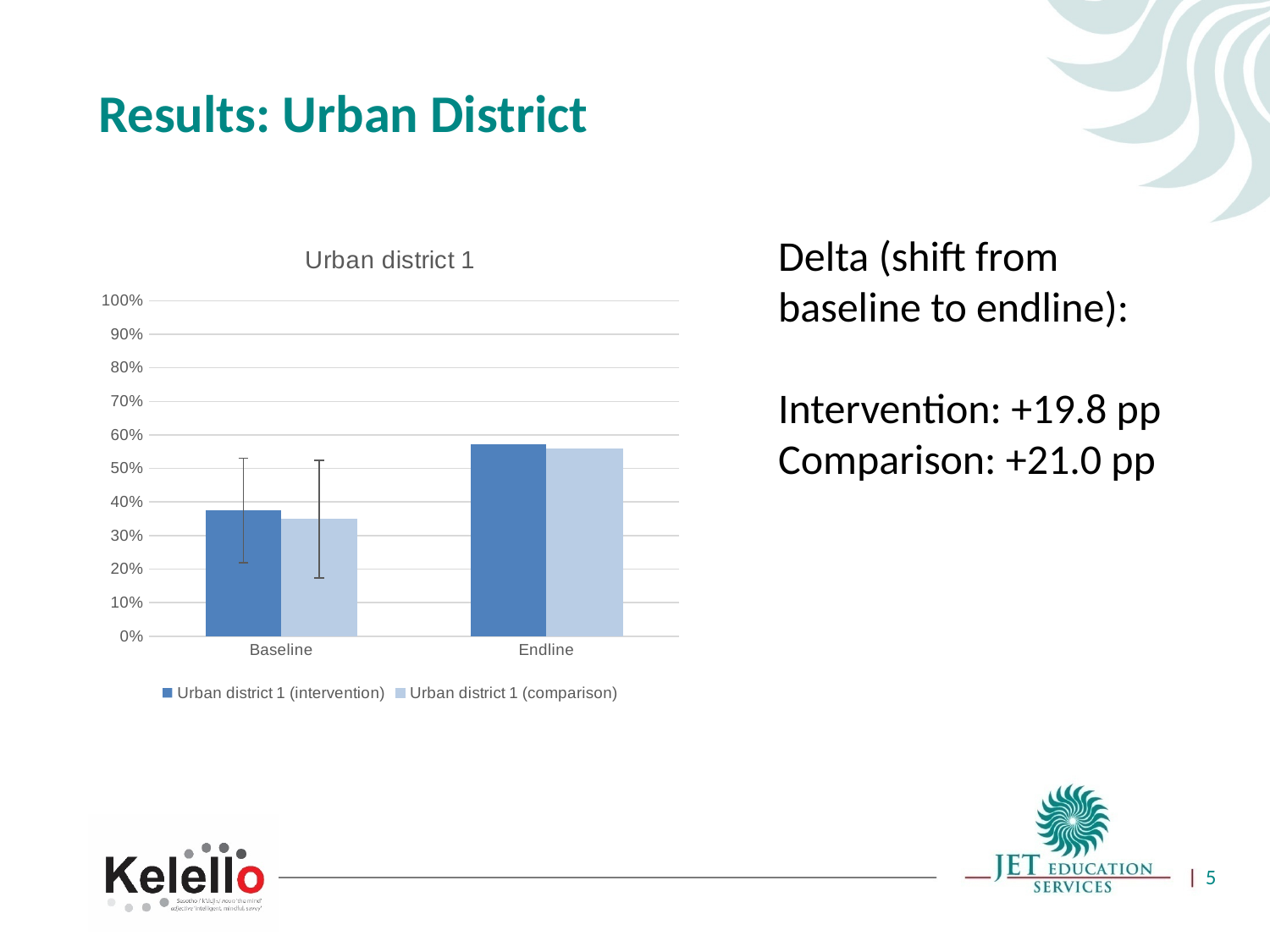
For Urban district 1 (intervention), which is larger: the Baseline value or the Endline value? Endline Is the Endline value for Urban district 1 (intervention) greater or less than 50%? greater Is the Endline value for Urban district 1 (comparison) greater or less than 60%? less Is the Baseline value for Urban district 1 (comparison) greater or less than 30%? greater Do the values for Urban district 1 (comparison) rise or fall from Baseline to Endline? Rise What is the title of the chart? Urban district 1 What are the two series named in the chart's legend? Urban district 1 (intervention) and Urban district 1 (comparison) How many categories are shown on the x axis of the chart? 2 How many series does the chart's legend list? 2 What kind of chart is shown on the slide? Bar chart